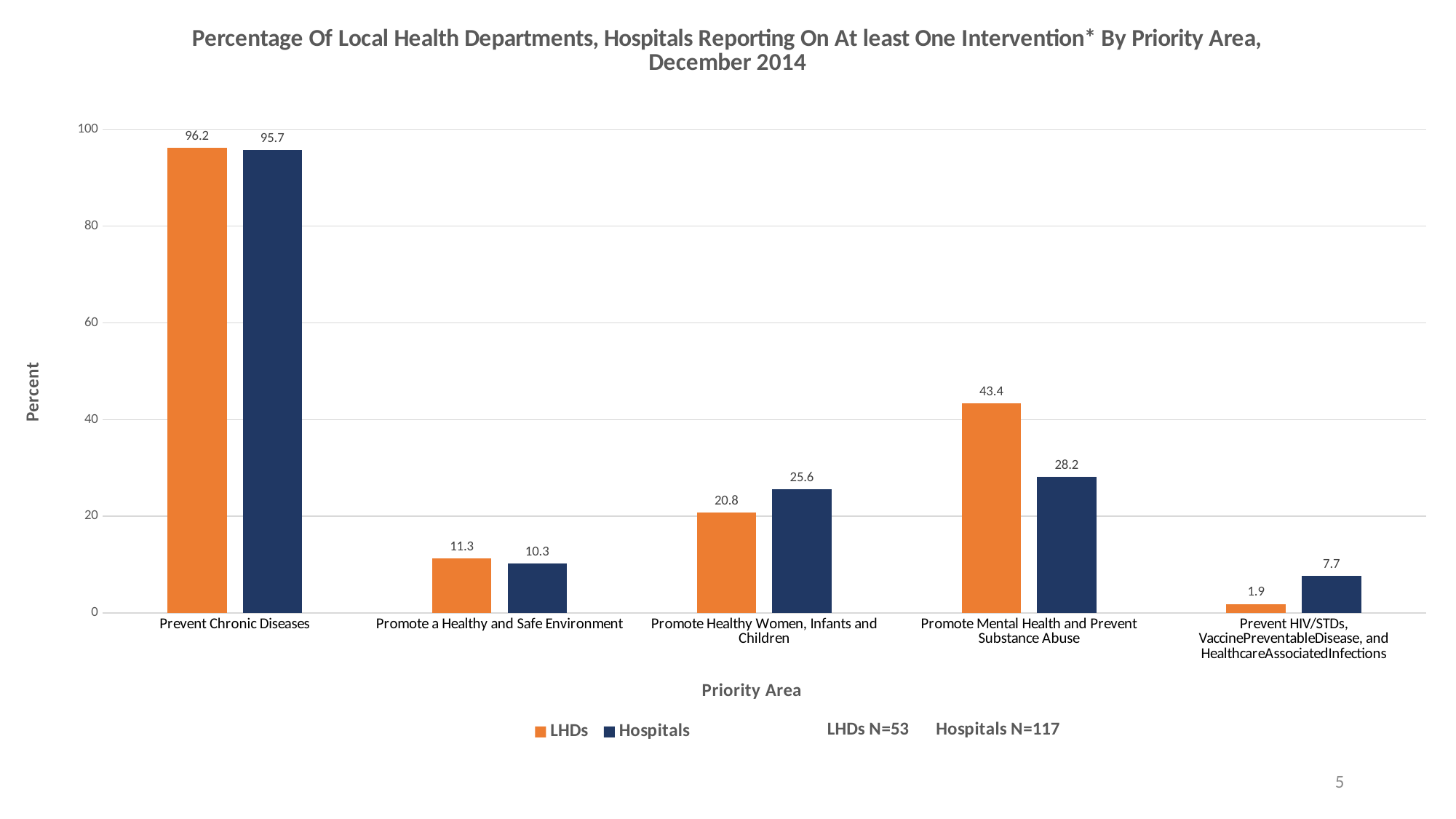
What is the label of the y axis? Percent What is the difference between the LHDs and Hospitals values for Promote Mental Health and Prevent Substance Abuse? 15.2 What kind of chart is shown on the slide? bar chart Which priority area has the highest Hospitals value? Prevent Chronic Diseases How many priority areas are shown on the x axis? 5 For Promote Healthy Women, Infants and Children, which series has the larger value, LHDs or Hospitals? Hospitals Is the Hospitals value for Promote Mental Health and Prevent Substance Abuse greater or less than 40? less What is the Hospitals value for Promote Healthy Women, Infants and Children? 25.6 Which priority area has the lowest LHDs value? Prevent HIV/STDs, VaccinePreventableDisease, and HealthcareAssociatedInfections What is the LHDs value for Prevent Chronic Diseases? 96.2 What is the LHDs value for Promote Mental Health and Prevent Substance Abuse? 43.4 How many series does the legend list? 2